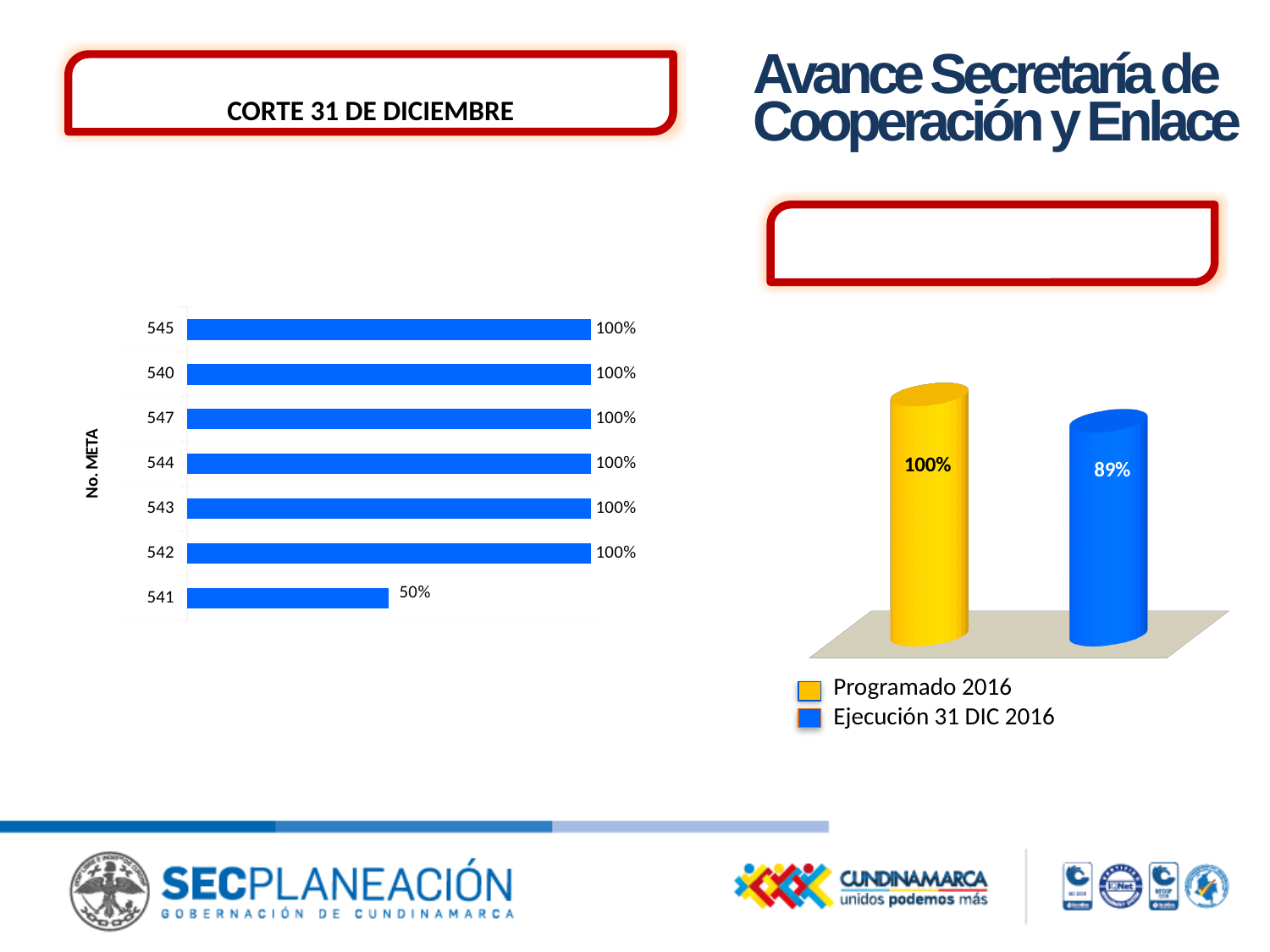
What kind of chart is the chart on the left? bar chart In the left bar chart, which meta has the lowest value? 541 How many metas are shown in the left bar chart? 7 What is the label of the vertical axis in the left bar chart? No. META In the left bar chart, what is the value for meta 541? 50% In the left bar chart, which is larger, the value for meta 543 or the value for meta 541? 543 In the right chart, what is the difference between Programado 2016 and Ejecución 31 DIC 2016? 11% In the left bar chart, what is the value for meta 545? 100% In the left bar chart, what is the difference between the value for meta 542 and the value for meta 541? 50% How many series does the legend of the right chart list? 2 In the right chart, what is the value for Programado 2016? 100% In the right chart, what is the value for Ejecución 31 DIC 2016? 89%